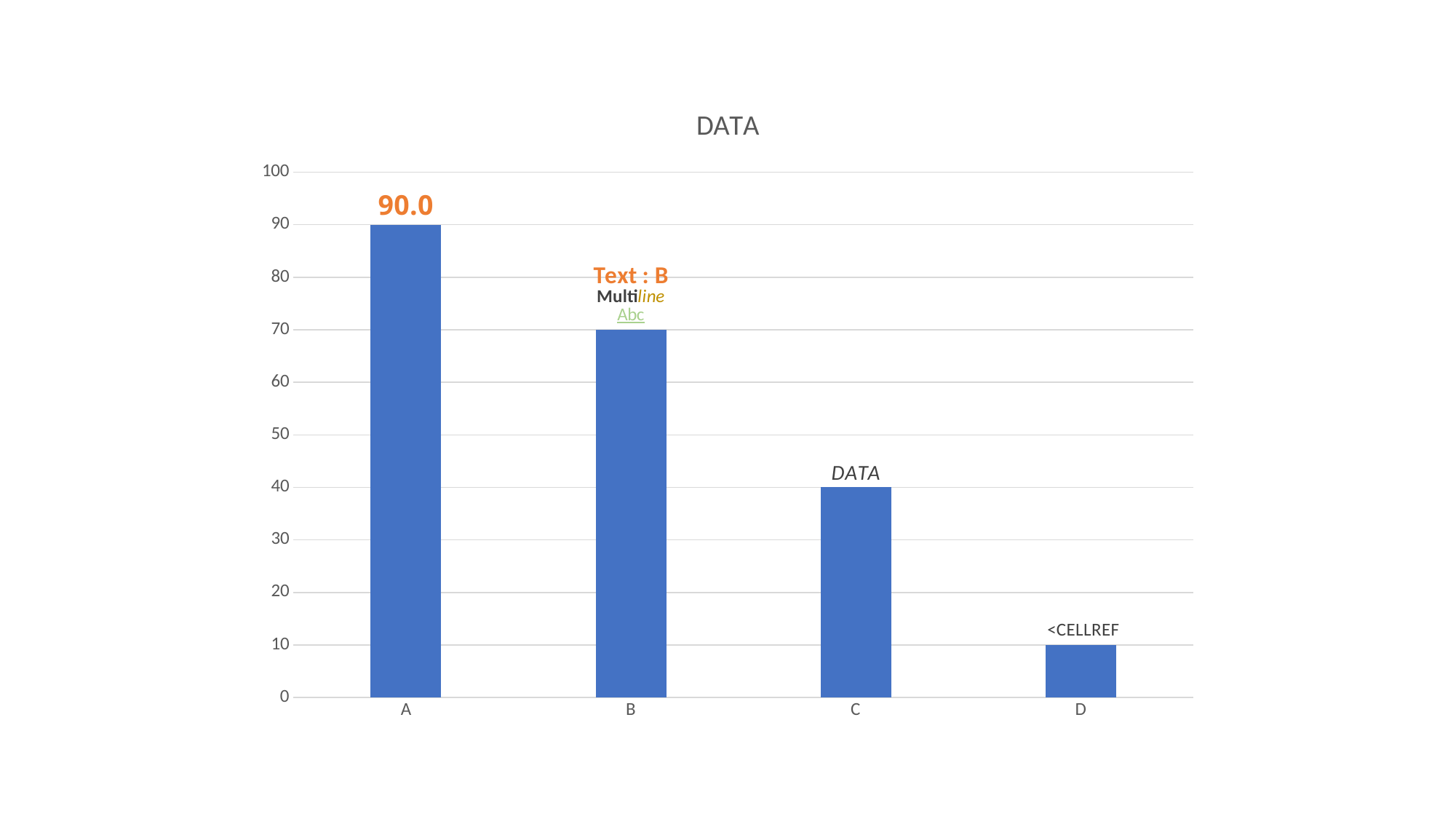
What is the value shown for category A? 90.0 What type of chart is shown on the slide? bar chart What value does the bar for category B reach on the y axis? 70 Do the values rise or fall from category A to category D? fall Which category has the highest value? A Which category has the lowest value? D Which is larger, the value for C or the value for D? C How many categories are plotted on the x axis? 4 What is the title of the chart? DATA What value does the bar for category D reach on the y axis? 10 What value does the bar for category C reach on the y axis? 40 What is the difference between the values for B and C? 30